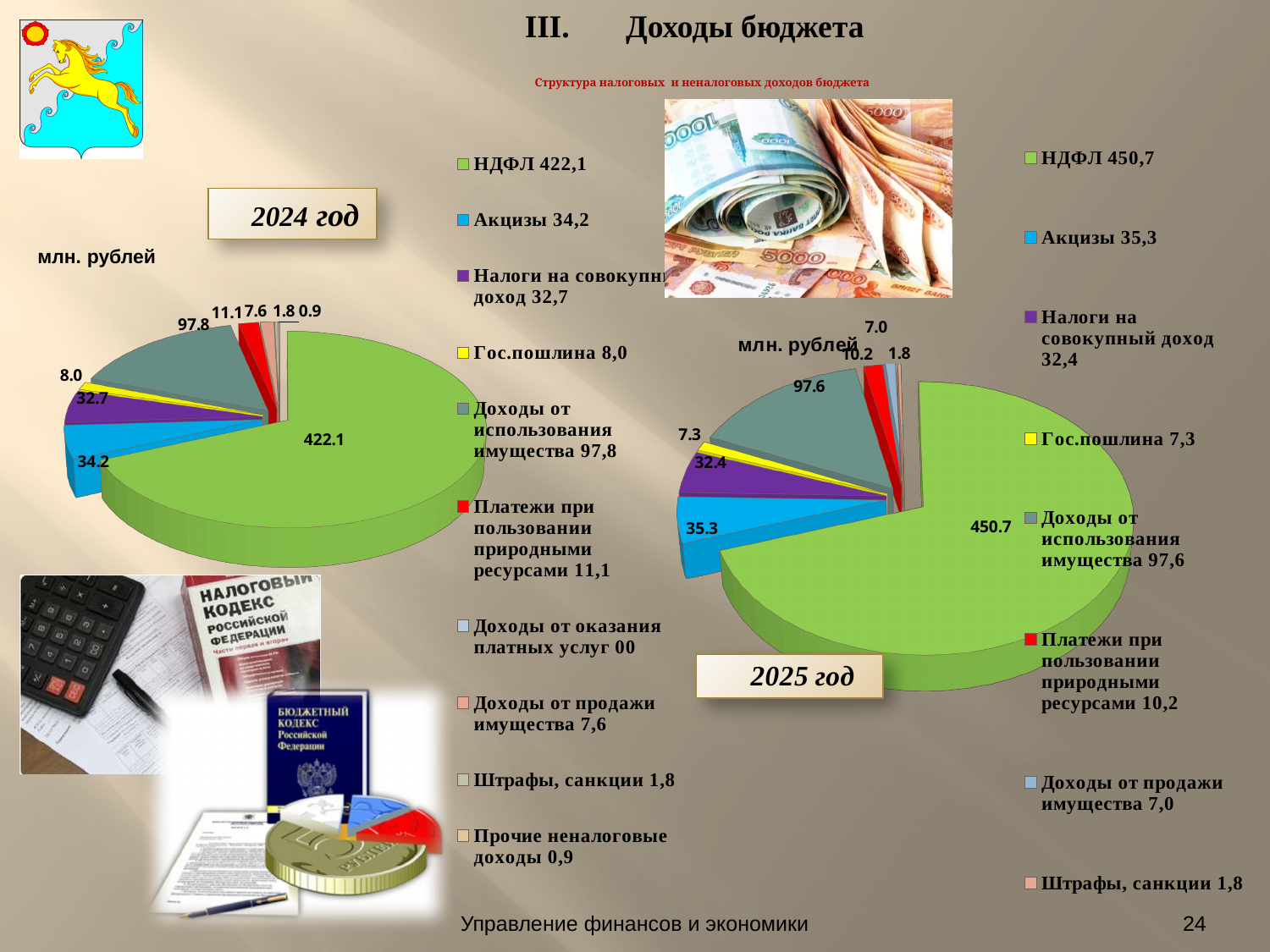
In the 2024 pie chart, which category has the smallest non-zero value? Прочие неналоговые доходы How many categories does the legend of the 2024 pie chart list? 10 What type of chart is used to show the 2024 budget revenue structure? Pie chart In the 2025 pie chart, which category has the largest value? НДФЛ In the 2024 pie chart, what is the value for НДФЛ? 422.1 What unit is indicated for the values in both pie charts? млн. рублей What is the difference between the НДФЛ value in the 2025 chart and the НДФЛ value in the 2024 chart? 28.6 In the 2025 pie chart, what is the value for Акцизы? 35.3 How many categories does the legend of the 2025 pie chart list? 8 In the 2025 pie chart, what is the value for Платежи при пользовании природными ресурсами? 10.2 In the 2024 pie chart, what is the value for Доходы от использования имущества? 97.8 In the 2024 pie chart, which is larger: Акцизы or Налоги на совокупный доход? Акцизы